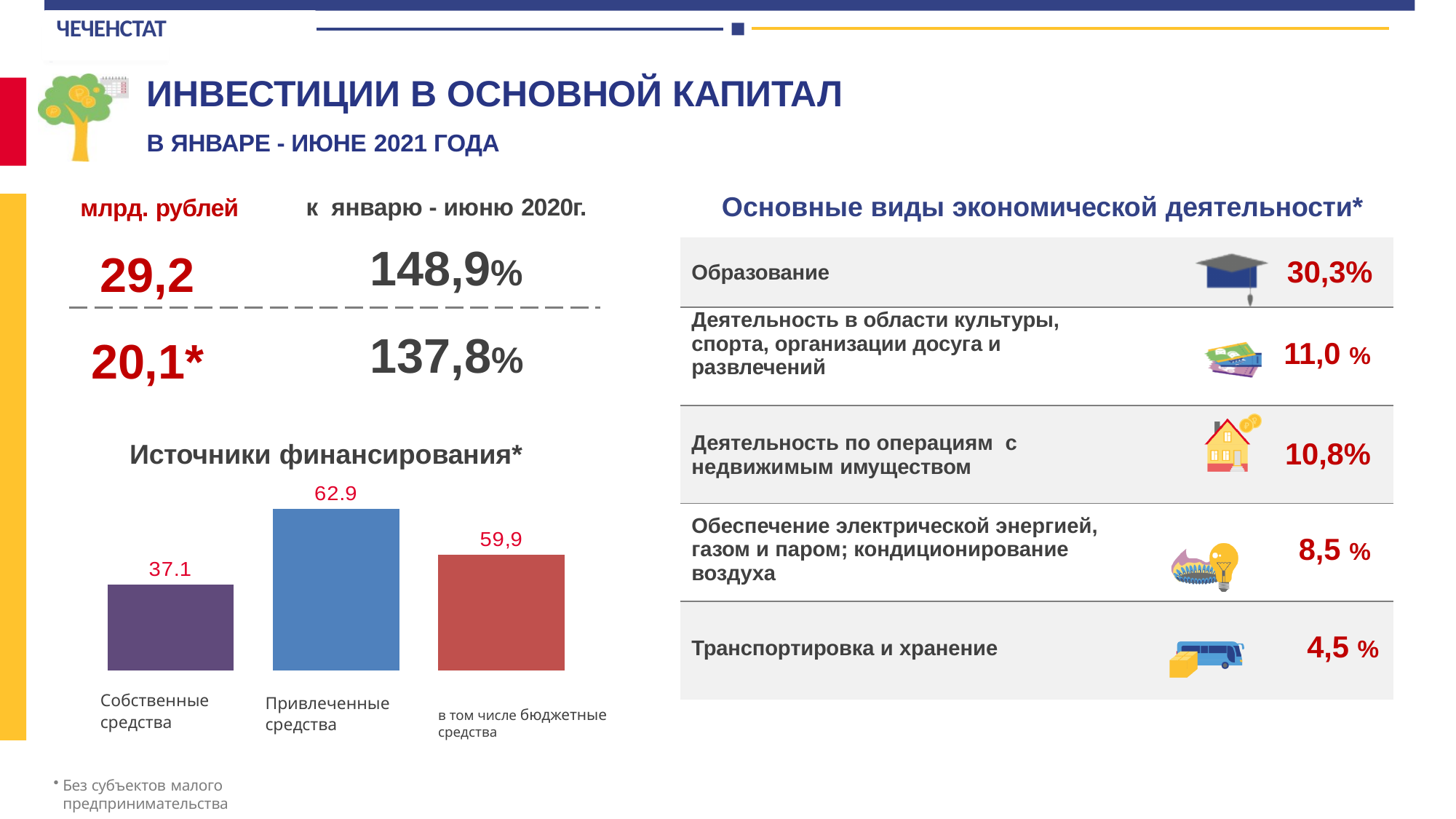
Which category has the highest value in the Источники финансирования chart? Привлеченные средства What is the value for в том числе бюджетные средства in the Источники финансирования chart? 59,9 What is the value for Собственные средства in the Источники финансирования chart? 37.1 What colour is the bar for Собственные средства in the Источники финансирования chart? purple In the Источники финансирования chart, which is larger: Привлеченные средства or в том числе бюджетные средства? Привлеченные средства What is the title of the chart on the slide? Источники финансирования* In the Источники финансирования chart, which is larger: Собственные средства or в том числе бюджетные средства? в том числе бюджетные средства How many bars are shown in the Источники финансирования chart? 3 Which category has the lowest value in the Источники финансирования chart? Собственные средства In the Источники финансирования chart, what is the difference between the values for Привлеченные средства and Собственные средства? 25.8 What kind of chart is the Источники финансирования chart? bar chart What is the value for Привлеченные средства in the Источники финансирования chart? 62.9